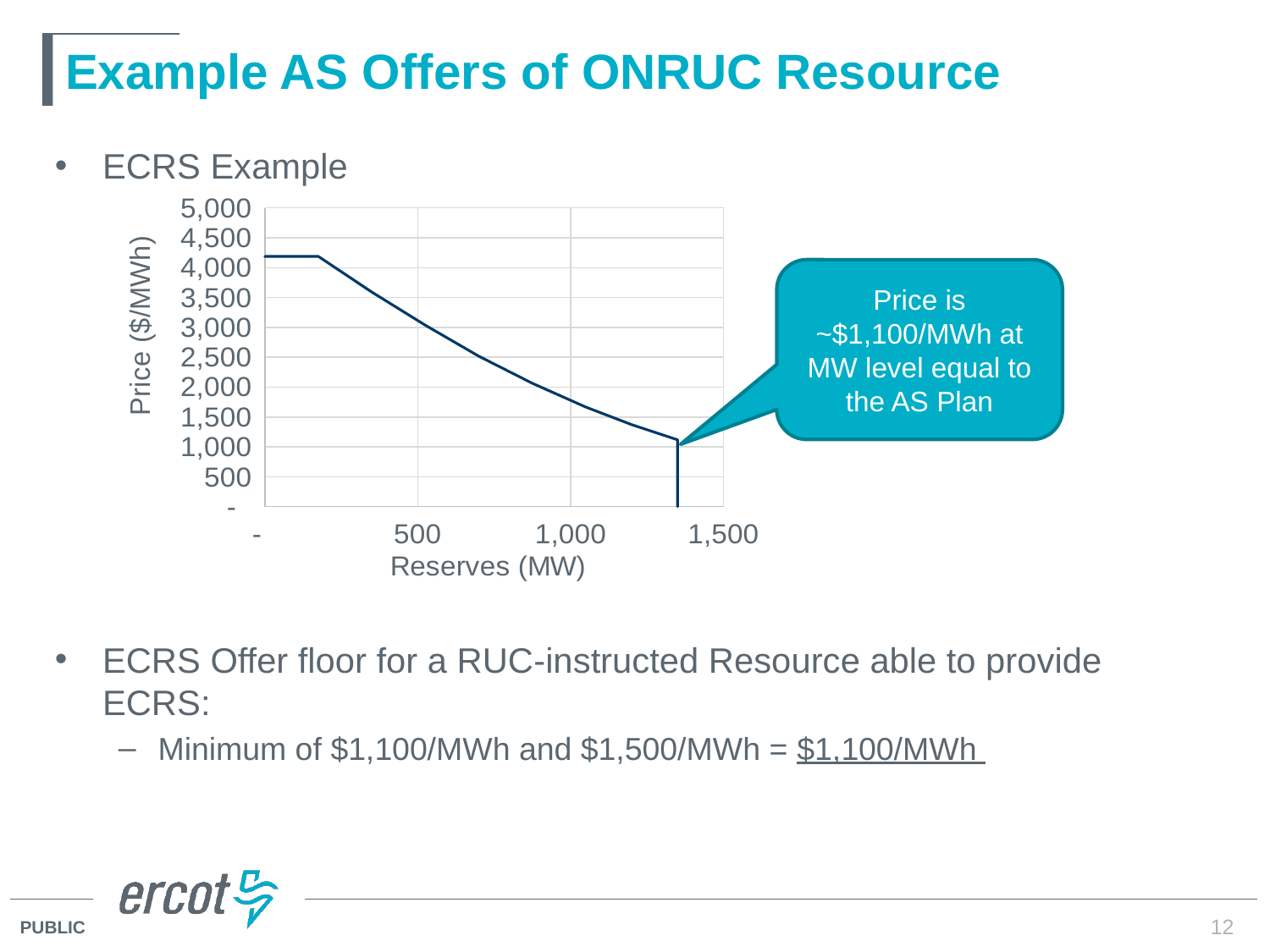
Is the highest price on the curve greater or less than 4,500 $/MWh? less What is the label of the x axis of the chart? Reserves (MW) What is the label of the y axis of the chart? Price ($/MWh) Is the price at 250 MW of reserves greater or less than 3,500 $/MWh? greater What kind of chart is shown on the slide? line chart Is the price at 1,000 MW of reserves greater or less than 2,000 $/MWh? less Does the price rise or fall as reserves increase along the x axis? fall